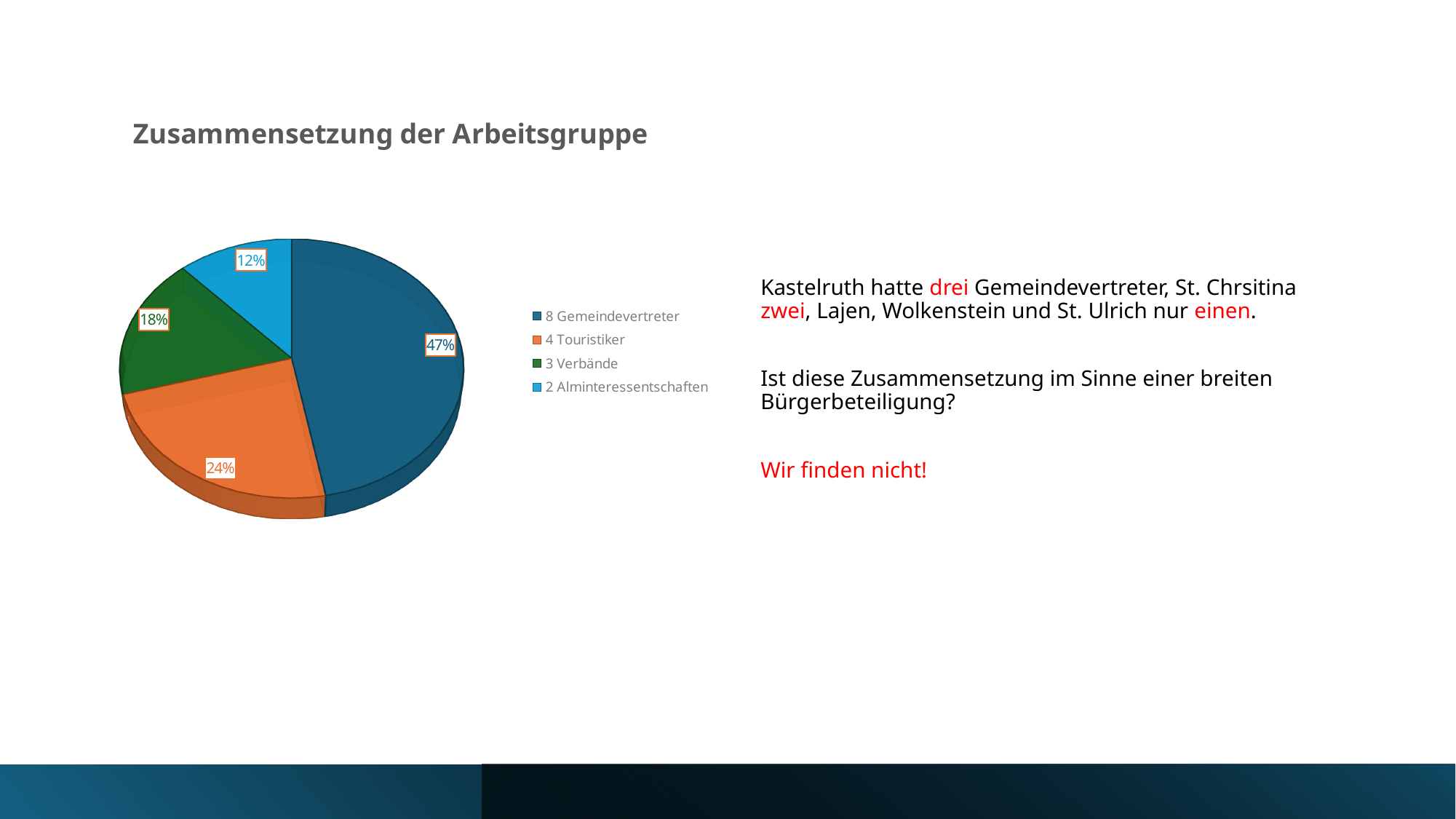
Which slice of the pie is the largest? 8 Gemeindevertreter What share of the pie does the "4 Touristiker" slice represent? 24% What is the title of the chart? Zusammensetzung der Arbeitsgruppe Which slice of the pie is the smallest? 2 Alminteressentschaften What share of the pie does the "8 Gemeindevertreter" slice represent? 47% What share of the pie does the "3 Verbände" slice represent? 18% What is the difference in percentage points between the "8 Gemeindevertreter" slice and the "4 Touristiker" slice? 23 What kind of chart is shown on the slide? pie chart How many slices does the pie chart have? 4 What colour is the "4 Touristiker" slice? orange Which slice is larger, "3 Verbände" or "2 Alminteressentschaften"? 3 Verbände